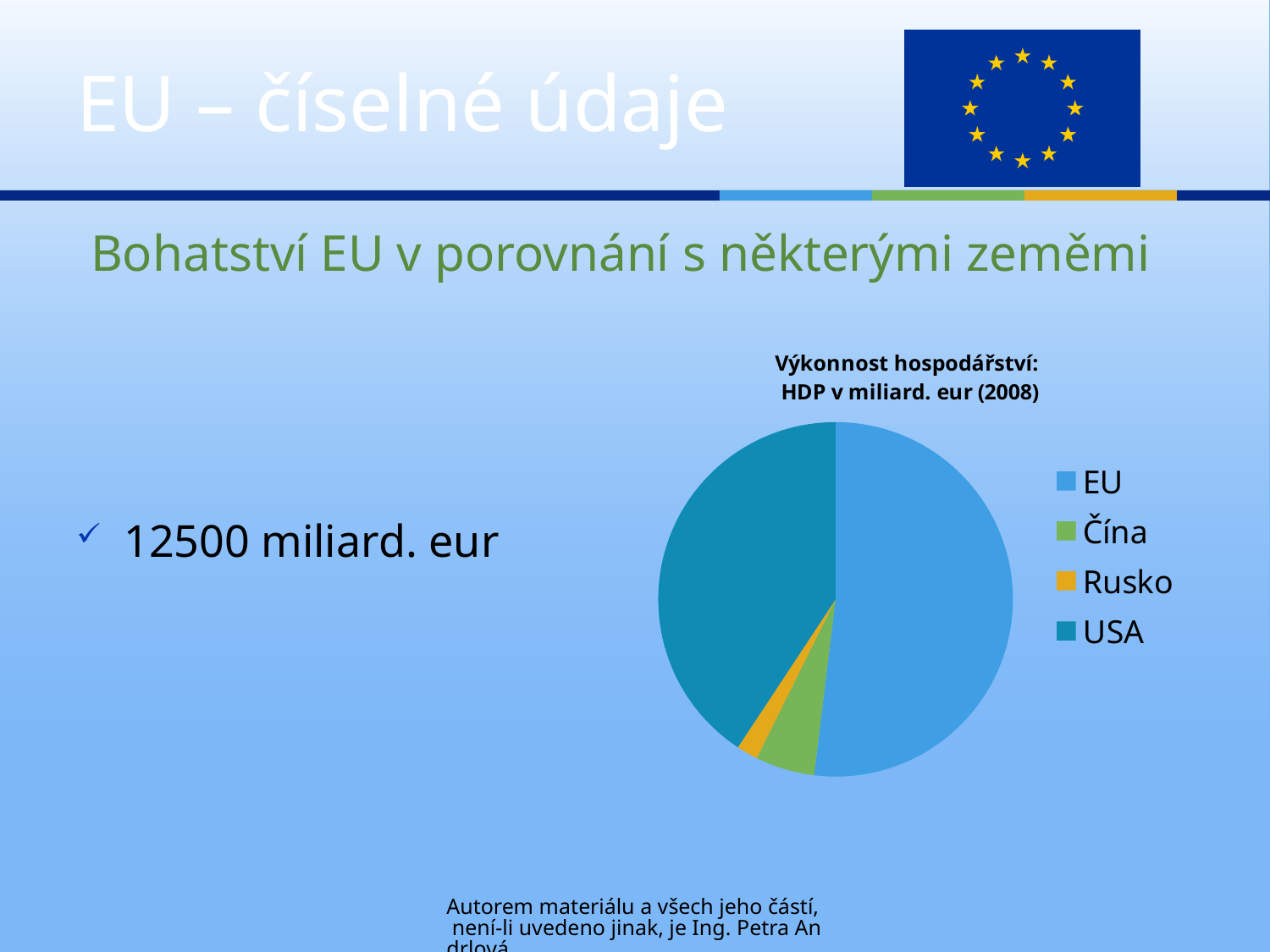
Which category has the smallest slice in the pie chart? Rusko How many entries does the legend of the pie chart list? 4 How many slices does the pie chart have? 4 Which slice is larger in the pie chart, Čína or Rusko? Čína What is the title of the pie chart? Výkonnost hospodářství: HDP v miliard. eur (2008) Which category has the largest slice in the pie chart? EU What kind of chart is shown on the slide? pie chart Which slice is larger in the pie chart, EU or USA? EU Which slice is larger in the pie chart, USA or Čína? USA Which colour represents Rusko in the pie chart? yellow/orange Which category is listed first in the legend of the pie chart? EU